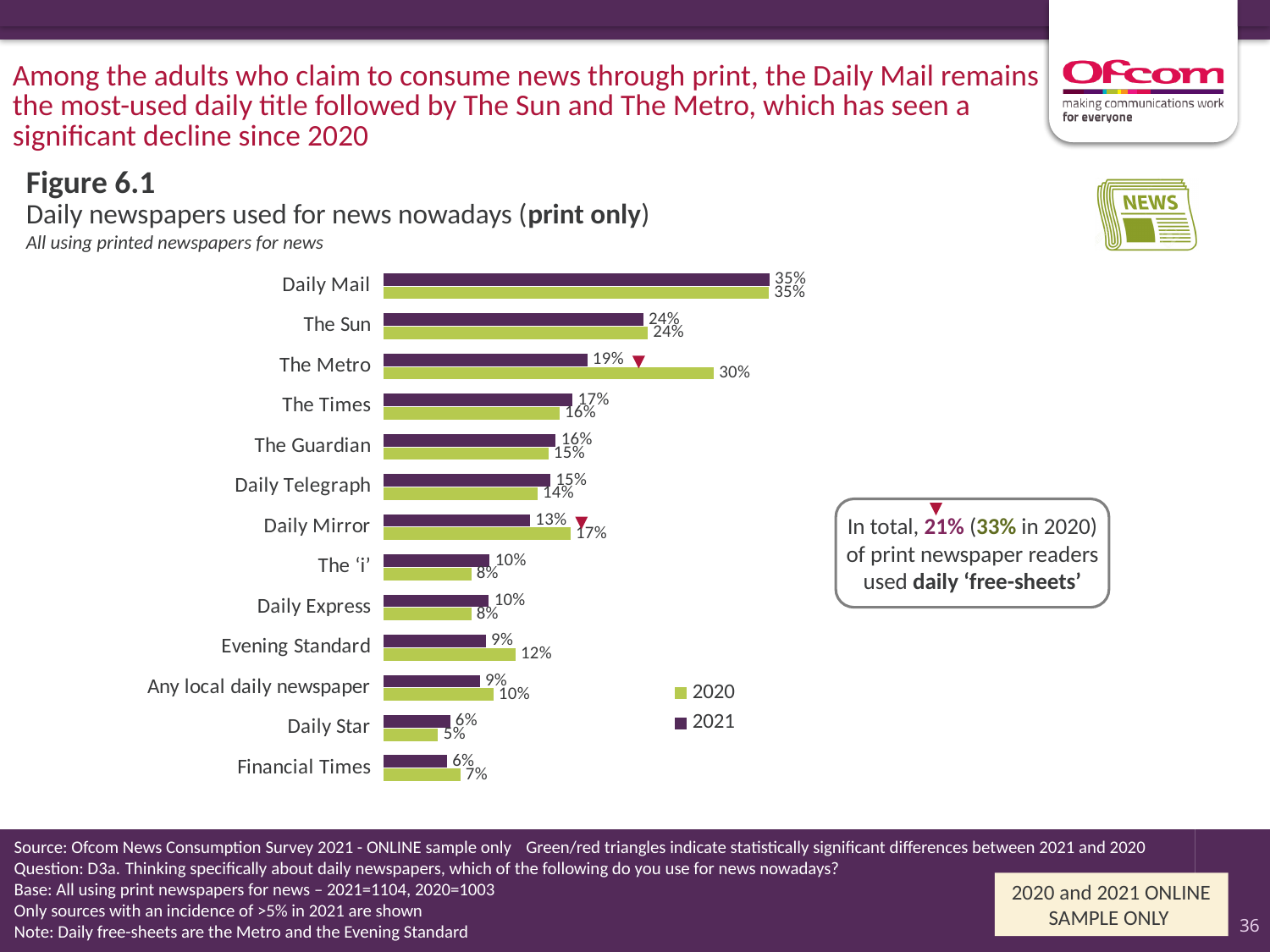
What is the difference between the 2021 values for The Sun and The Times? 7 How many series does the legend list? 2 Which was larger for the Daily Mirror: the 2020 value or the 2021 value? 2020 Which newspaper has the lowest 2020 value? Daily Star How many newspaper categories are shown in the chart? 13 What was the 2020 value for The Metro? 30% What was the 2020 value for the Evening Standard? 12% By how many percentage points did The Metro's value fall from 2020 to 2021? 11 What percentage of print newspaper readers used the Daily Mail for news in 2021? 35% Which daily newspaper has the highest 2021 value? Daily Mail What type of chart is shown on the slide? Bar chart What was the 2021 value for the Daily Mirror? 13%